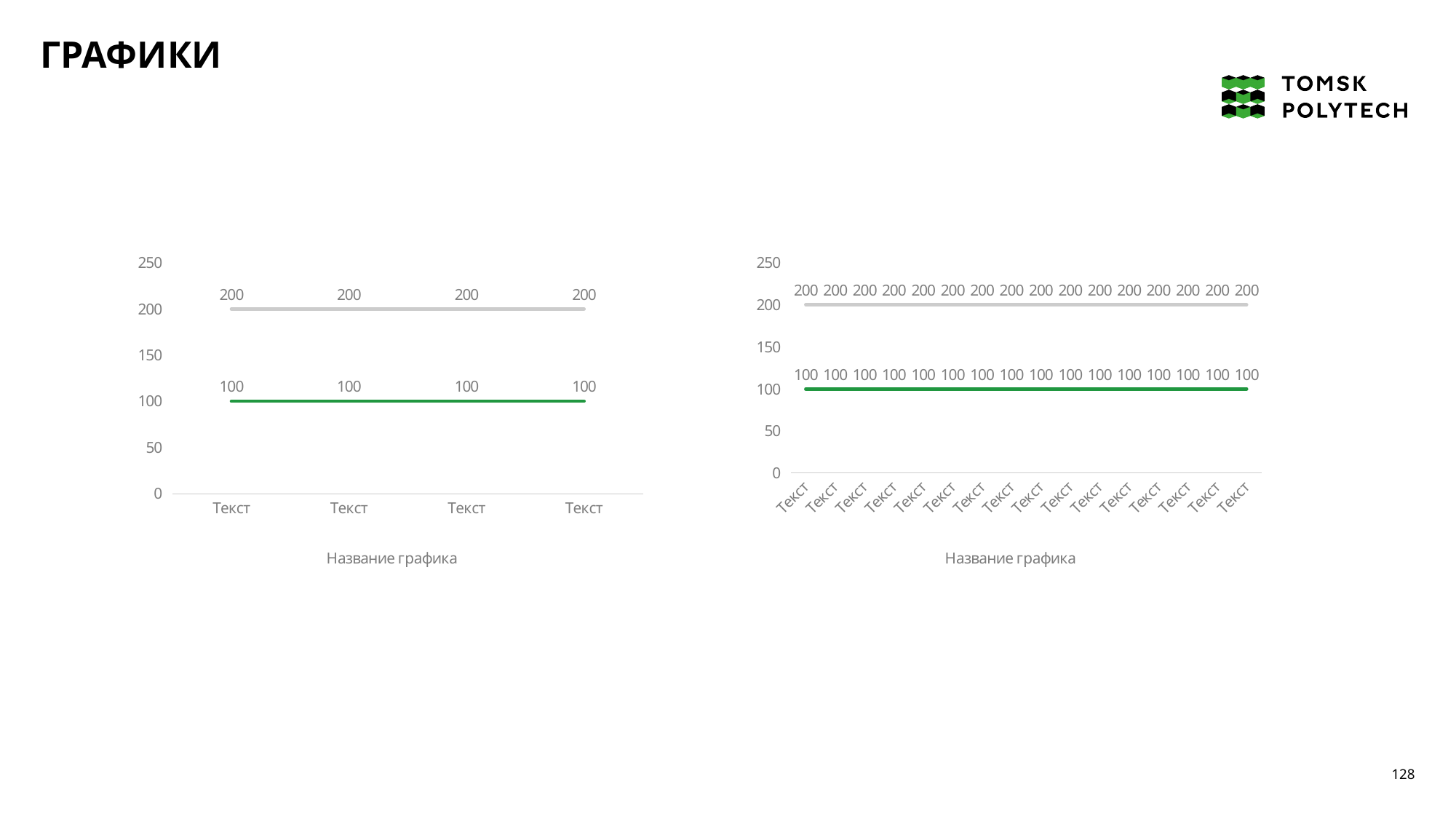
In the left chart, what is the difference between the grey line value and the green line value? 100 What is the maximum value shown on the y axis of the left chart? 250 In the right chart, what value is labelled on the grey line? 200 How many data points does the right chart have along the x axis? 16 What kind of chart is the left chart? line chart In the right chart, do the values of the green line rise, fall or stay flat along the x axis? stay flat What kind of chart is the right chart? line chart In the left chart, what value is labelled on the grey line? 200 In the left chart, which line has the higher values, the grey one or the green one? grey What is the title shown under the right chart? Название графика In the left chart, what value is labelled on the green line? 100 How many data points does the left chart have along the x axis? 4